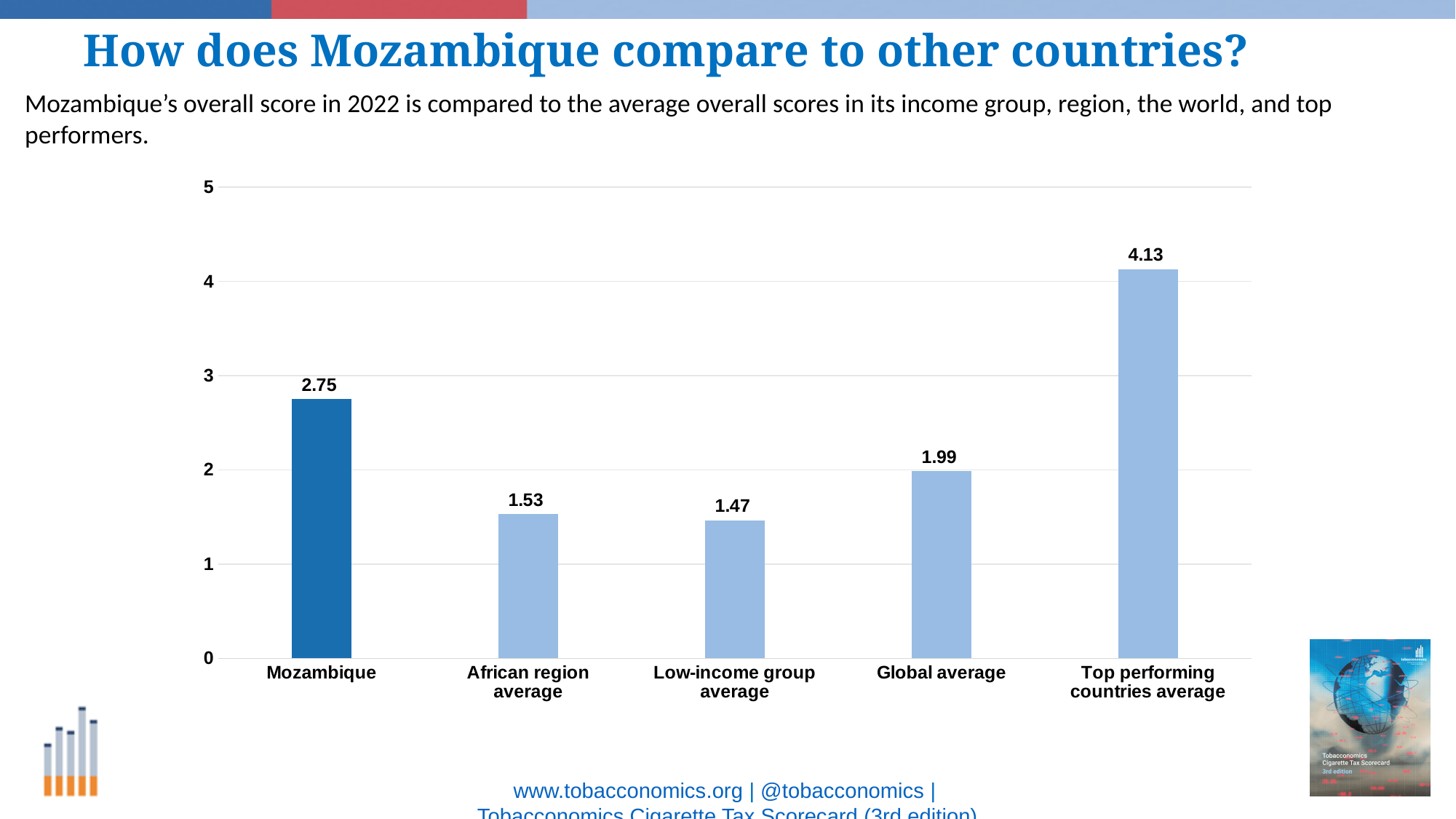
How many categories are shown in the chart? 5 Which category has the lowest value? Low-income group average What is the value for Mozambique? 2.75 What is the difference between Mozambique and the Global average? 0.76 Which is larger, Mozambique or the African region average? Mozambique What kind of chart is shown on the slide? Bar chart What is the value for the Top performing countries average? 4.13 What is the difference between the Top performing countries average and Mozambique? 1.38 What is the value for the Low-income group average? 1.47 What is the value for the African region average? 1.53 Which category has the highest value? Top performing countries average What is the value for the Global average? 1.99